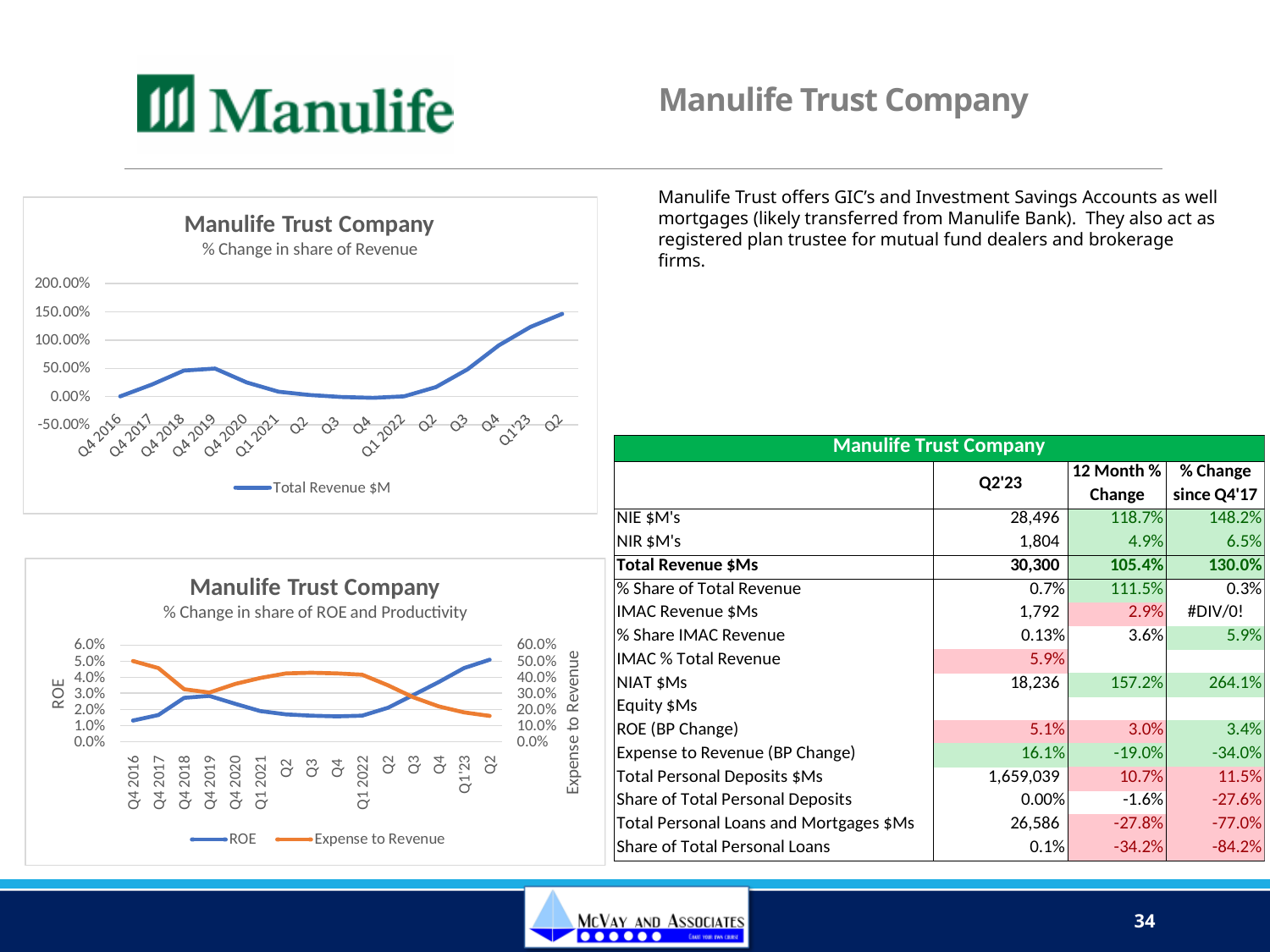
In the top chart (% Change in share of Revenue), does the Total Revenue $M line overall rise or fall from Q4 2016 to the final Q2? Rise In the bottom chart (% Change in share of ROE and Productivity), at which x-axis point is the Expense to Revenue line highest? Q4 2016 In the bottom chart (% Change in share of ROE and Productivity), does the Expense to Revenue line overall rise or fall from Q4 2016 to the final Q2? Fall In the top chart (% Change in share of Revenue), how many series does the legend list? 1 In the bottom chart (% Change in share of ROE and Productivity), how many series does the legend list? 2 In the top chart (% Change in share of Revenue), is the value at the last point (Q2 2023) greater or less than 100.00%? greater In the top chart (% Change in share of Revenue), how many points are plotted along the x axis? 15 In the top chart (% Change in share of Revenue), is the value at Q3 2022 greater or less than 50.00%? less In the top chart (% Change in share of Revenue), at which x-axis point is the Total Revenue $M value highest? Q2 (the last point, 2023) In the bottom chart (% Change in share of ROE and Productivity), is the ROE value at the last point (Q2 2023) greater or less than 4.0%? greater What kind of chart is the top chart titled 'Manulife Trust Company – % Change in share of Revenue'? Line chart In the top chart (% Change in share of Revenue), what is the name of the series shown in the legend? Total Revenue $M